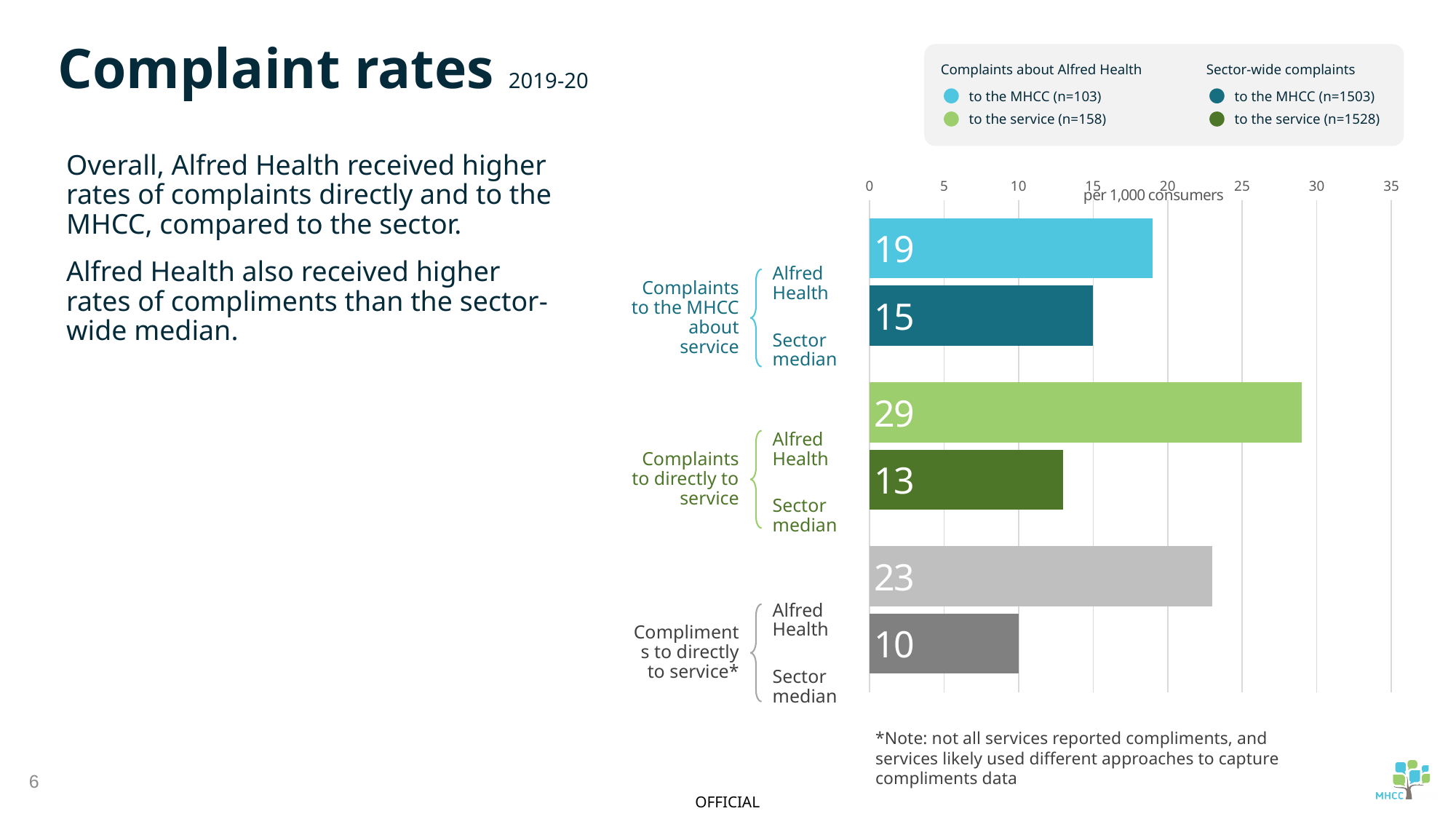
What is the sector median value for complaints to the MHCC about service? 15 What is the difference between the Alfred Health and sector median values for complaints directly to service? 16 What is the Alfred Health value for complaints to the MHCC about service? 19 How many bars are plotted on the chart? 6 What is the difference between the Alfred Health and sector median values for compliments directly to service? 13 Which is larger: the Alfred Health value for complaints to the MHCC about service or the sector median value for complaints directly to service? Alfred Health value for complaints to the MHCC about service Which bar has the highest value on the chart? Alfred Health, complaints directly to service Which bar has the lowest value on the chart? Sector median, compliments directly to service What unit does the chart's axis label say the values are measured in? per 1,000 consumers What is the sector median value for compliments directly to service? 10 What kind of chart is shown on the slide? Bar chart What is the Alfred Health value for complaints directly to service? 29